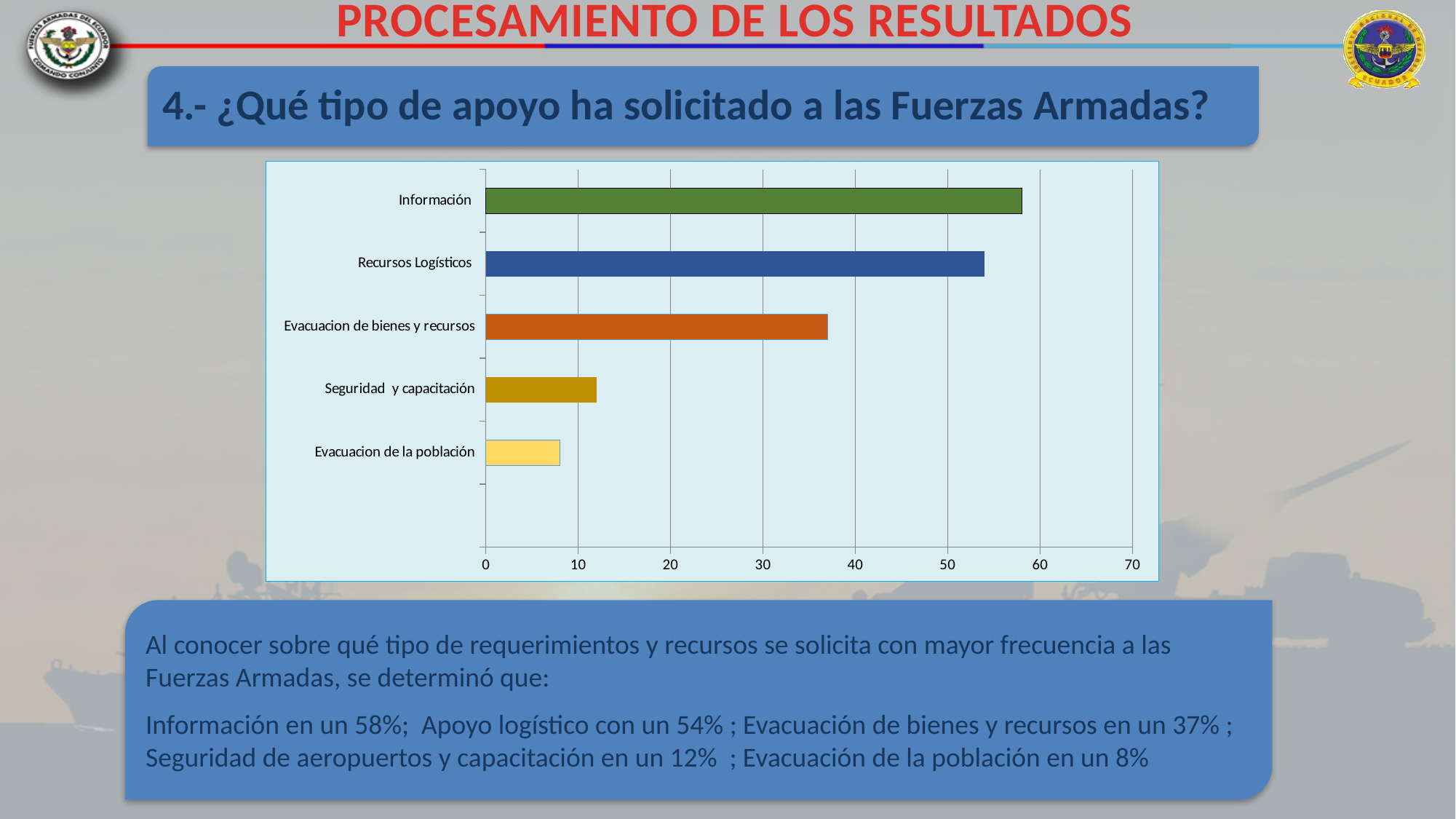
According to the slide text, what percentage corresponds to Información? 58% Is the value for Evacuacion de bienes y recursos greater or less than 40? less How many categories are plotted in the bar chart? 5 Is the value for Evacuacion de la población greater or less than 10? less According to the slide text, what percentage corresponds to Evacuación de la población? 8% Which category has the longest bar in the chart? Información Which is larger, the value for Recursos Logísticos or the value for Evacuacion de bienes y recursos? Recursos Logísticos What kind of chart is shown on the slide? bar chart What is the maximum value shown on the horizontal axis of the chart? 70 Is the value for Información greater or less than 50? greater Which category has the shortest bar in the chart? Evacuacion de la población